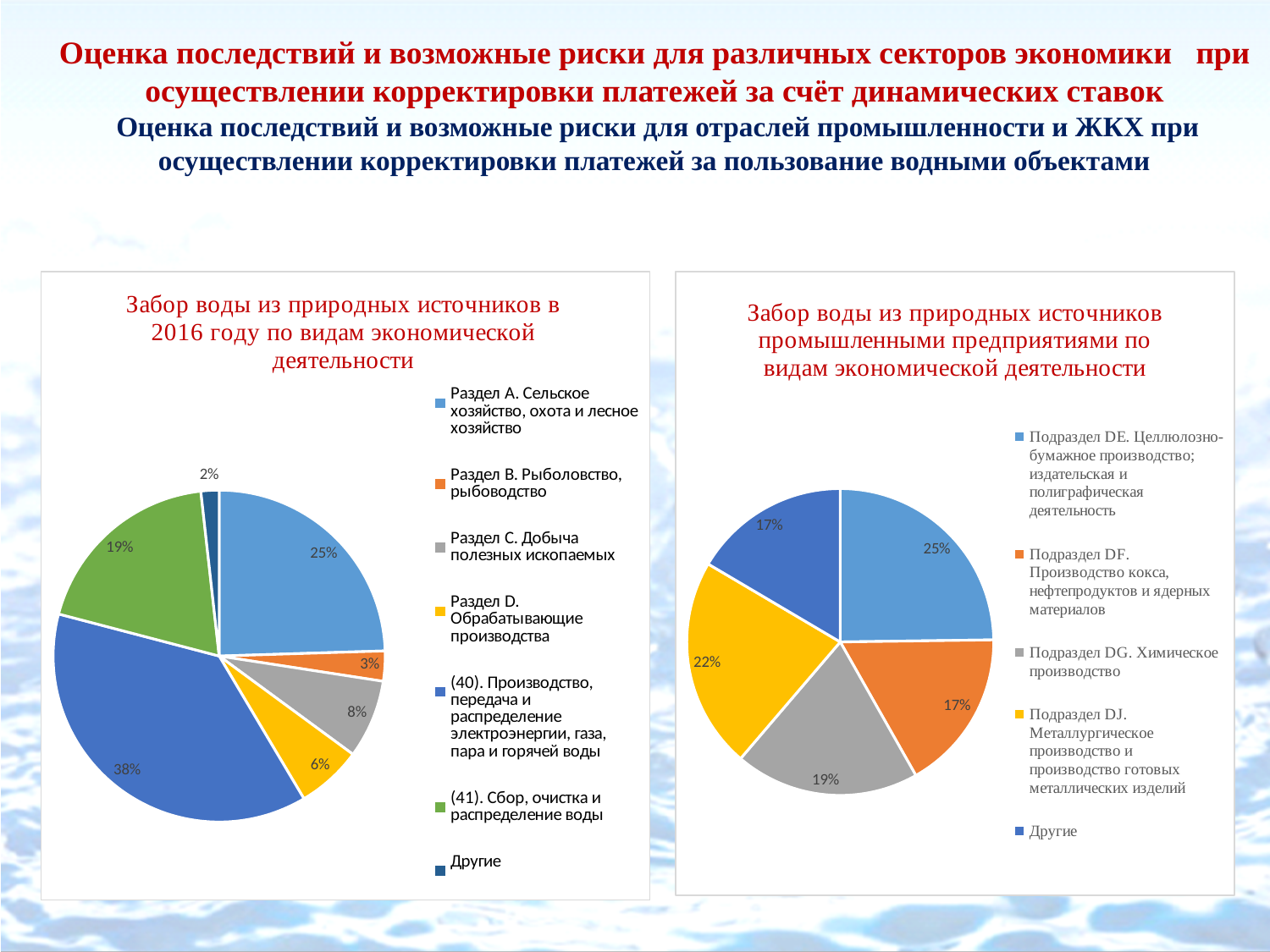
On the left chart (Забор воды из природных источников в 2016 году), which is larger: Раздел D. Обрабатывающие производства or Раздел B. Рыболовство, рыбоводство? Раздел D. Обрабатывающие производства On the left chart (Забор воды из природных источников в 2016 году), which category has the smallest slice? Другие On the left chart (Забор воды из природных источников в 2016 году), what is the difference between the shares of (41). Сбор, очистка и распределение воды and Раздел C. Добыча полезных ископаемых? 11% On the left chart (Забор воды из природных источников в 2016 году), which category has the largest slice? (40). Производство, передача и распределение электроэнергии, газа, пара и горячей воды On the right chart (Забор воды из природных источников промышленными предприятиями), which category has the largest slice? Подраздел DE. Целлюлозно-бумажное производство; издательская и полиграфическая деятельность On the right chart (Забор воды из природных источников промышленными предприятиями), how many entries does the legend list? 5 What type of chart is used on the right side of the slide (Забор воды из природных источников промышленными предприятиями)? Pie chart On the left chart (Забор воды из природных источников в 2016 году), how many slices does the pie have? 7 On the right chart (Забор воды из природных источников промышленными предприятиями), what is the difference between the shares of Подраздел DG. Химическое производство and Подраздел DF. Производство кокса, нефтепродуктов и ядерных материалов? 2% On the right chart (Забор воды из природных источников промышленными предприятиями), what share is labelled for Подраздел DJ. Металлургическое производство и производство готовых металлических изделий? 22% On the left chart (Забор воды из природных источников в 2016 году по видам экономической деятельности), what share is labelled for Раздел A. Сельское хозяйство, охота и лесное хозяйство? 25% On the left chart (Забор воды из природных источников в 2016 году), what share is labelled for (40). Производство, передача и распределение электроэнергии, газа, пара и горячей воды? 38%